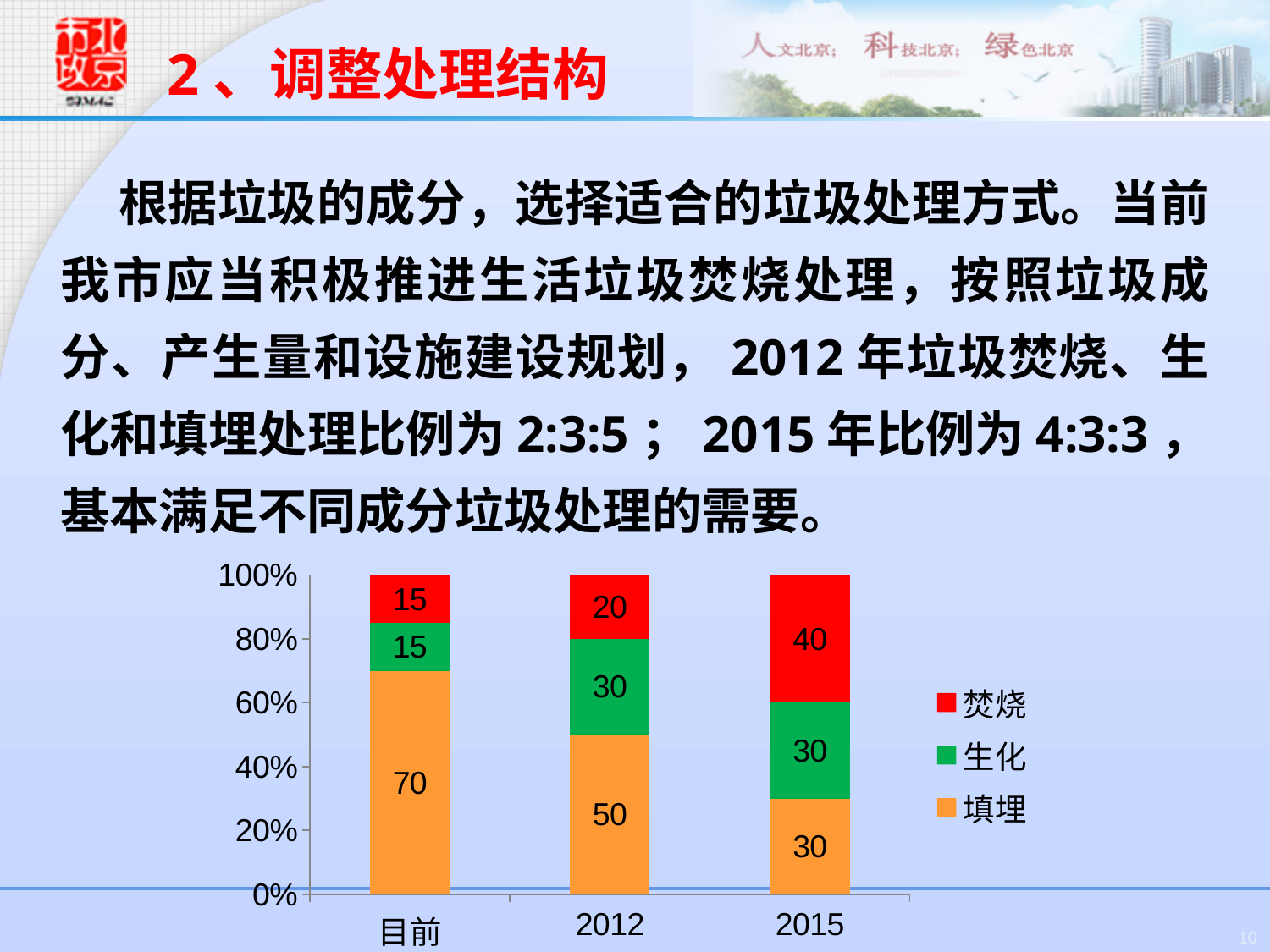
How many series does the legend list? 3 Which is larger: 焚烧 in 2012 or 焚烧 in 2015? 2015 Which category has the lowest value for 焚烧? 目前 What kind of chart is shown on the slide? stacked bar chart What is the difference between the 填埋 values for 目前 and 2015? 40 What is the value for 生化 in the 2012 bar? 30 Does the value for 焚烧 rise or fall from 目前 to 2015? rise What is the value for 焚烧 in the 2015 bar? 40 What is the value for 填埋 in the 目前 bar? 70 Which category has the highest value for 填埋? 目前 How many categories are shown on the x axis? 3 What is the value for 焚烧 in the 2012 bar? 20